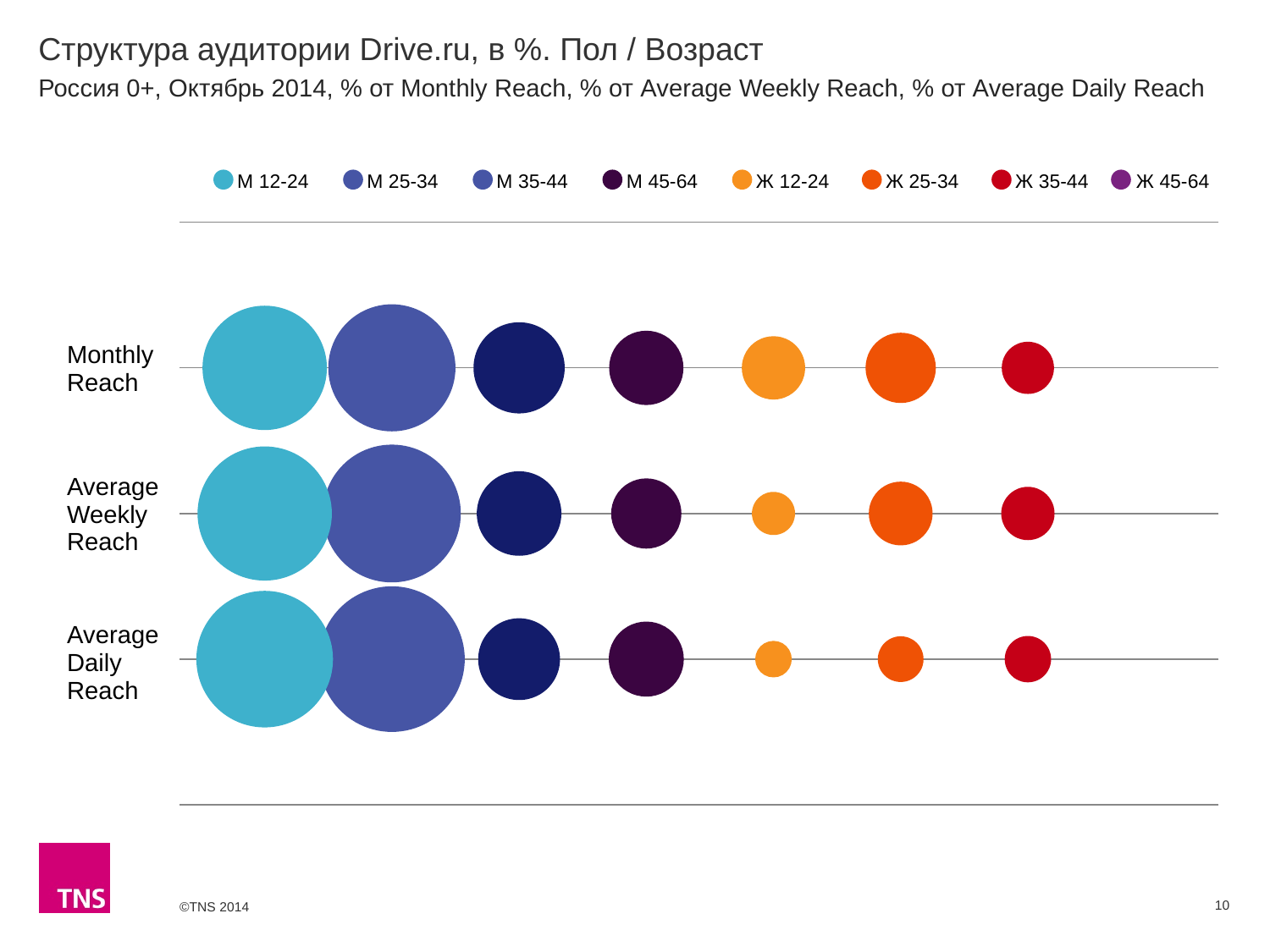
In the Monthly Reach row, which bubble is larger: М 12-24 or Ж 35-44? М 12-24 What is the title of the chart on the slide? Структура аудитории Drive.ru, в %. Пол / Возраст In the Average Daily Reach row, which visible series has the smallest bubble? Ж 12-24 In the Average Weekly Reach row, which bubble is larger: М 25-34 or Ж 35-44? М 25-34 Does the bubble for Ж 12-24 get larger or smaller going from Monthly Reach to Average Daily Reach? Smaller How many reach categories (rows) are plotted on the chart? 3 What colour is the Ж 35-44 series in the legend? Red Does the bubble for Ж 25-34 get larger or smaller going from Monthly Reach to Average Daily Reach? Smaller How many series does the legend list? 8 In the Monthly Reach row, which bubble is larger: М 35-44 or Ж 12-24? М 35-44 What kind of chart is shown on the slide? Bubble chart